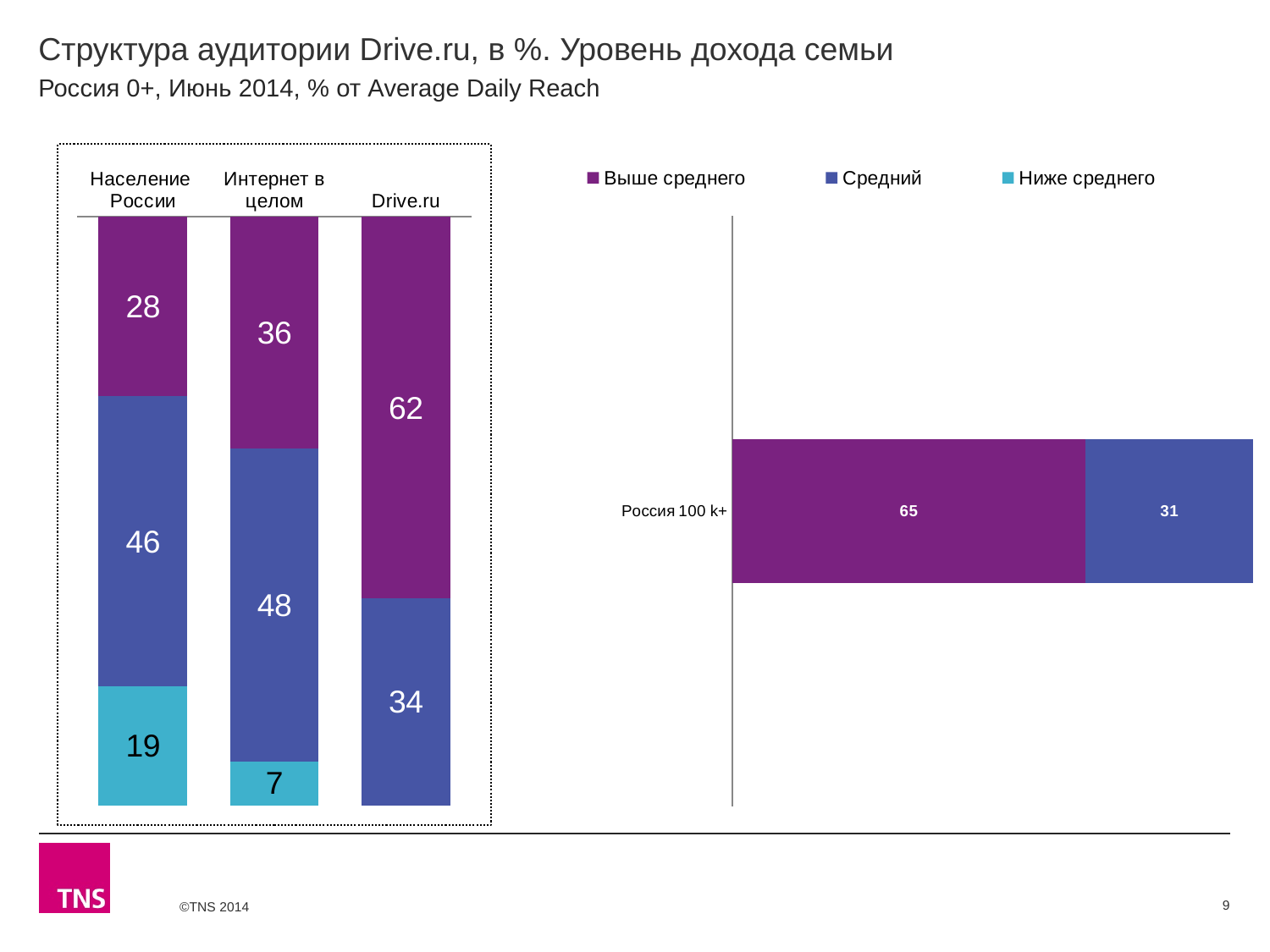
In the left chart, what is the value of the 'Ниже среднего' segment for 'Интернет в целом'? 7 In the left chart, what is the difference between the 'Выше среднего' values for Drive.ru and 'Население России'? 34 In the left chart, which category has the lowest 'Ниже среднего' value among those with a printed label? Интернет в целом How many categories are shown in the left chart? 3 In the left chart, what is the value of the 'Выше среднего' segment for Drive.ru? 62 In the left chart, what is the value of the 'Средний' segment for 'Население России'? 46 In the left chart, which category has the highest 'Выше среднего' value? Drive.ru In the right chart, what is the value of the 'Средний' segment for 'Россия 100 k+'? 31 How many series does the legend list? 3 In the left chart, which is larger: the 'Средний' value for 'Интернет в целом' or for Drive.ru? Интернет в целом What type of chart is the right chart? Stacked bar chart In the right chart, what is the value of the 'Выше среднего' segment for 'Россия 100 k+'? 65